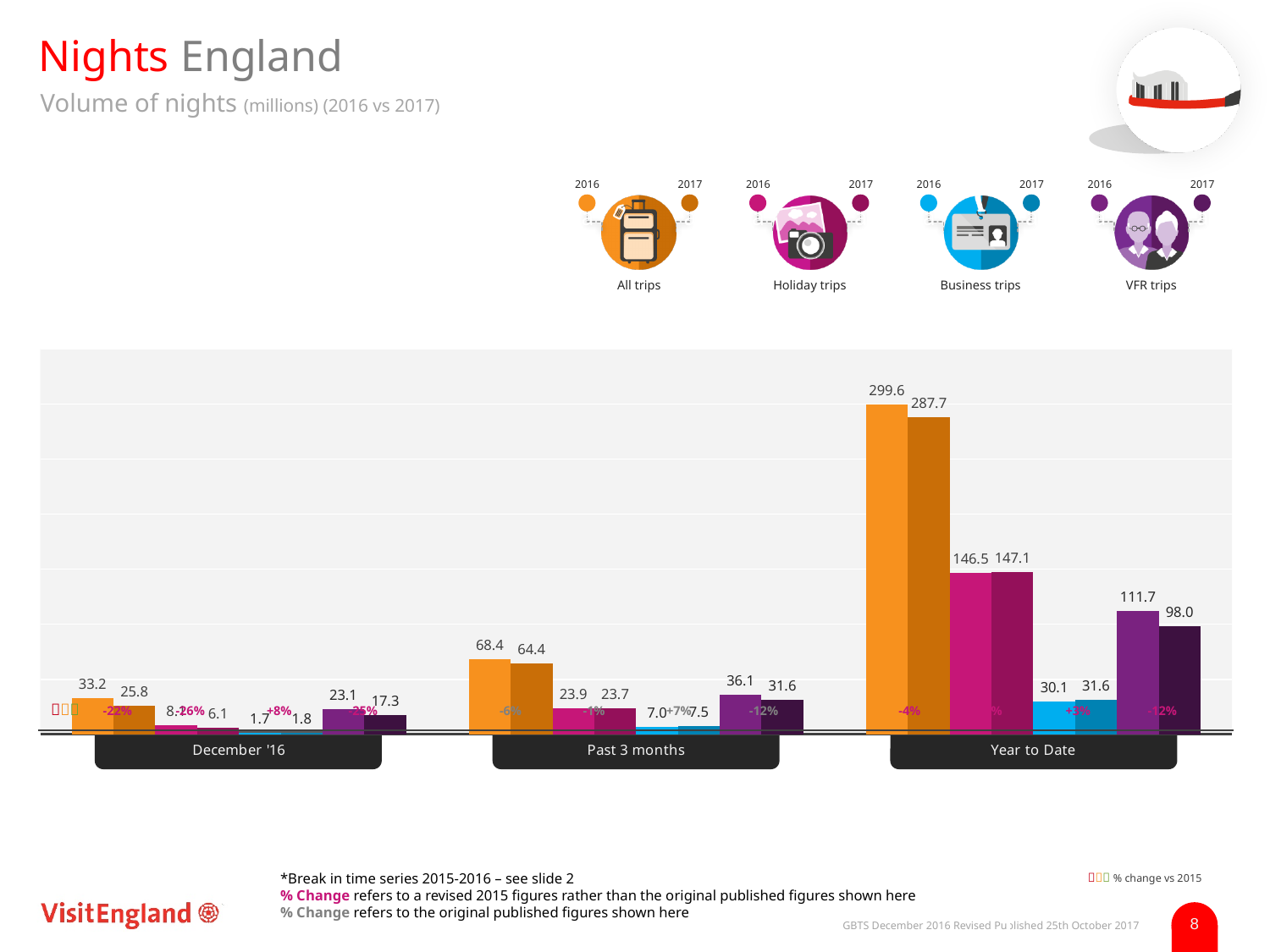
For Past 3 months, which is larger: All trips 2016 or All trips 2017? All trips 2016 How many time-period groups are shown on the x axis? 3 What is the volume of nights for All trips in 2017 for December '16? 25.8 What kind of chart is shown on the slide? Bar chart What is the difference between All trips 2016 and All trips 2017 for Year to Date? 11.9 What is the volume of nights for Holiday trips in 2017 for Year to Date? 147.1 What is the volume of nights for All trips in 2017 for Year to Date? 287.7 What is the difference between VFR trips 2016 and VFR trips 2017 for Year to Date? 13.7 What is the volume of nights for All trips in 2016 for Year to Date? 299.6 For Year to Date, which is larger: VFR trips 2016 or Business trips 2017? VFR trips 2016 What is the volume of nights for VFR trips in 2016 for Past 3 months? 36.1 Which bar is the highest on the chart? All trips 2016, Year to Date